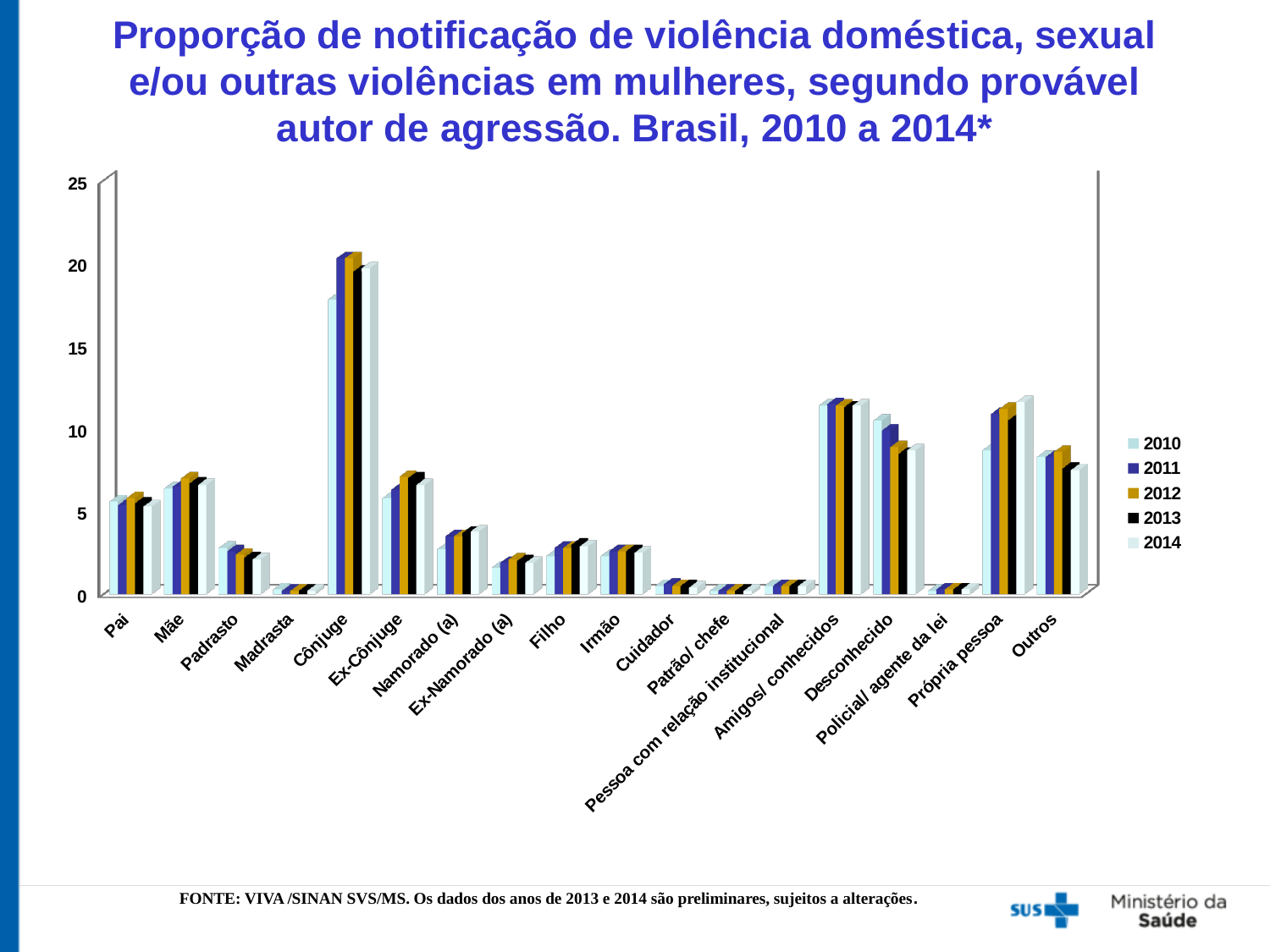
What kind of chart is shown on the slide? bar chart Is the value for Mãe in 2012 greater or less than 5? greater Which years are listed in the chart legend? 2010, 2011, 2012, 2013, 2014 Is the value for Amigos/ conhecidos in 2011 greater or less than 10? greater How many series does the legend list? 5 Do the values for Desconhecido rise or fall from 2010 to 2014? fall Is the value for Cônjuge in 2010 greater or less than 15? greater Which is larger in 2013, the value for Desconhecido or the value for Cuidador? Desconhecido Which is larger in 2012, the value for Cônjuge or the value for Amigos/ conhecidos? Cônjuge How many categories of provável autor de agressão are shown on the x axis? 18 Which category has the highest bars in the chart? Cônjuge